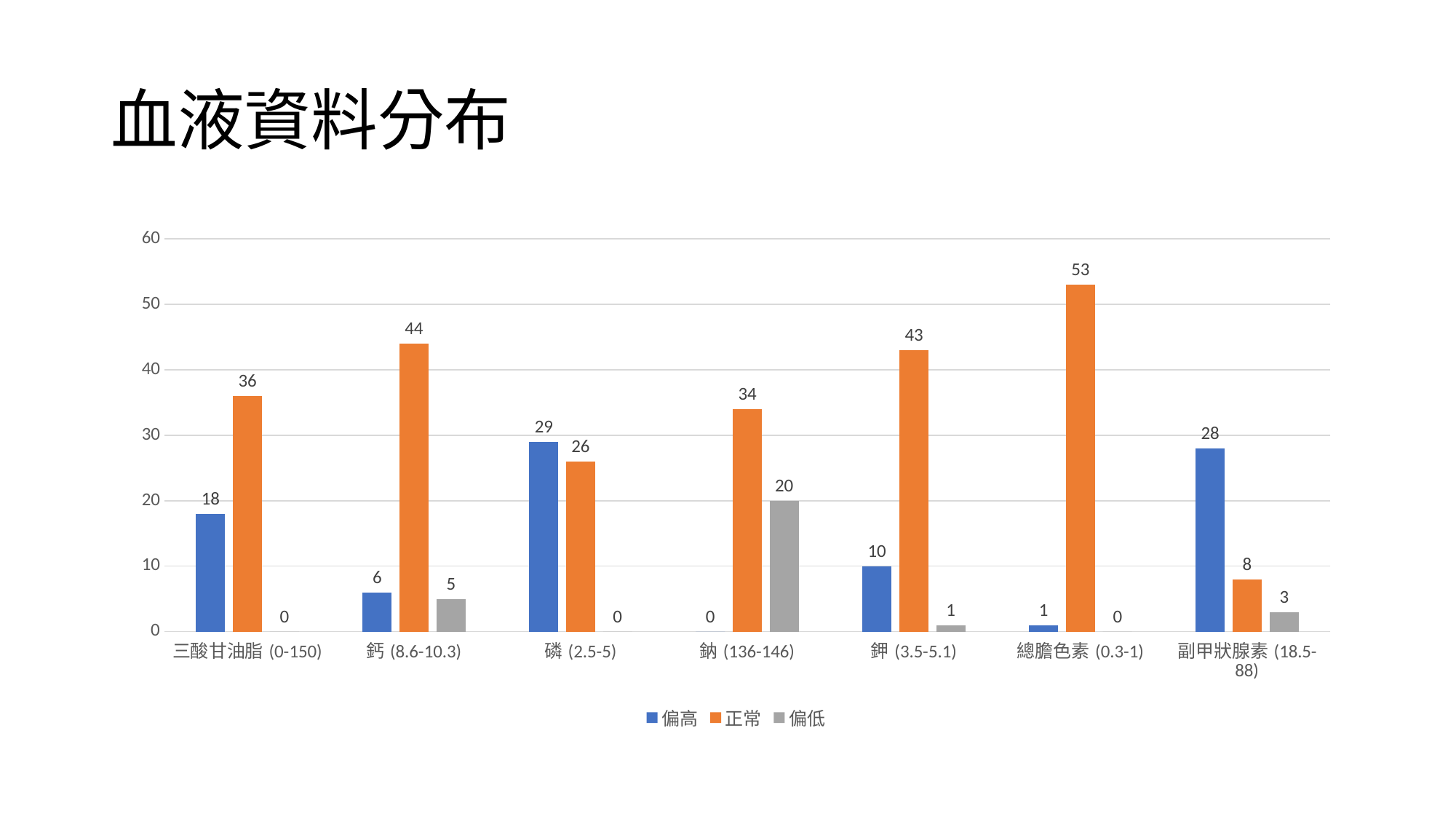
Which category has the lowest 正常 value? 副甲狀腺素 (18.5-88) What is the 偏高 value for 副甲狀腺素 (18.5-88)? 28 Which category has the highest 正常 value? 總膽色素 (0.3-1) Which is larger for 鉀 (3.5-5.1): the 偏高 value or the 正常 value? 正常 How many categories are shown on the x axis? 7 What is the 正常 value for 鈣 (8.6-10.3)? 44 What is the difference between the 偏高 and 正常 values for 磷 (2.5-5)? 3 What is the 偏低 value for 鈉 (136-146)? 20 What kind of chart is shown on the slide? bar chart Is the 正常 value for 鈉 (136-146) greater or less than 30? greater What is the title of the slide? 血液資料分布 How many series does the legend list? 3